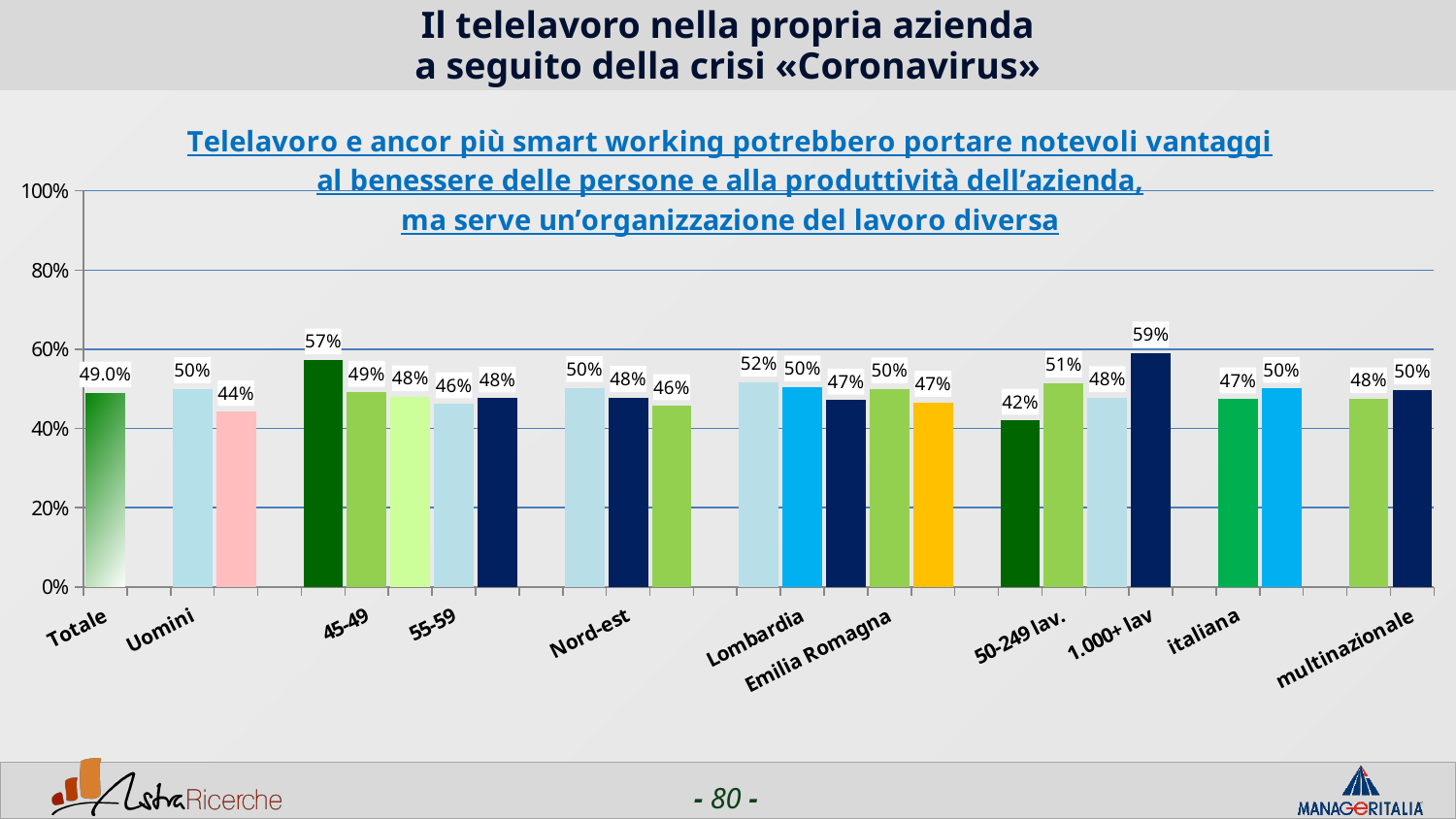
What is the lowest value shown in the chart? 42% What is the difference between the highest value (59%) and the lowest value (42%) in the chart? 17 percentage points What type of chart is shown on the slide? bar chart What is the highest value shown in the chart? 59% Which is larger, the value for Totale or the value for Uomini? Uomini Is the value for Totale greater or less than 40%? greater What is the title of the slide containing the chart? Il telelavoro nella propria azienda a seguito della crisi «Coronavirus» What is the value for Uomini? 50% How many bars are plotted in the chart? 24 What is the value for Totale? 49.0% What is the maximum value shown on the vertical axis? 100% Is the highest bar in the chart greater or less than 80%? less